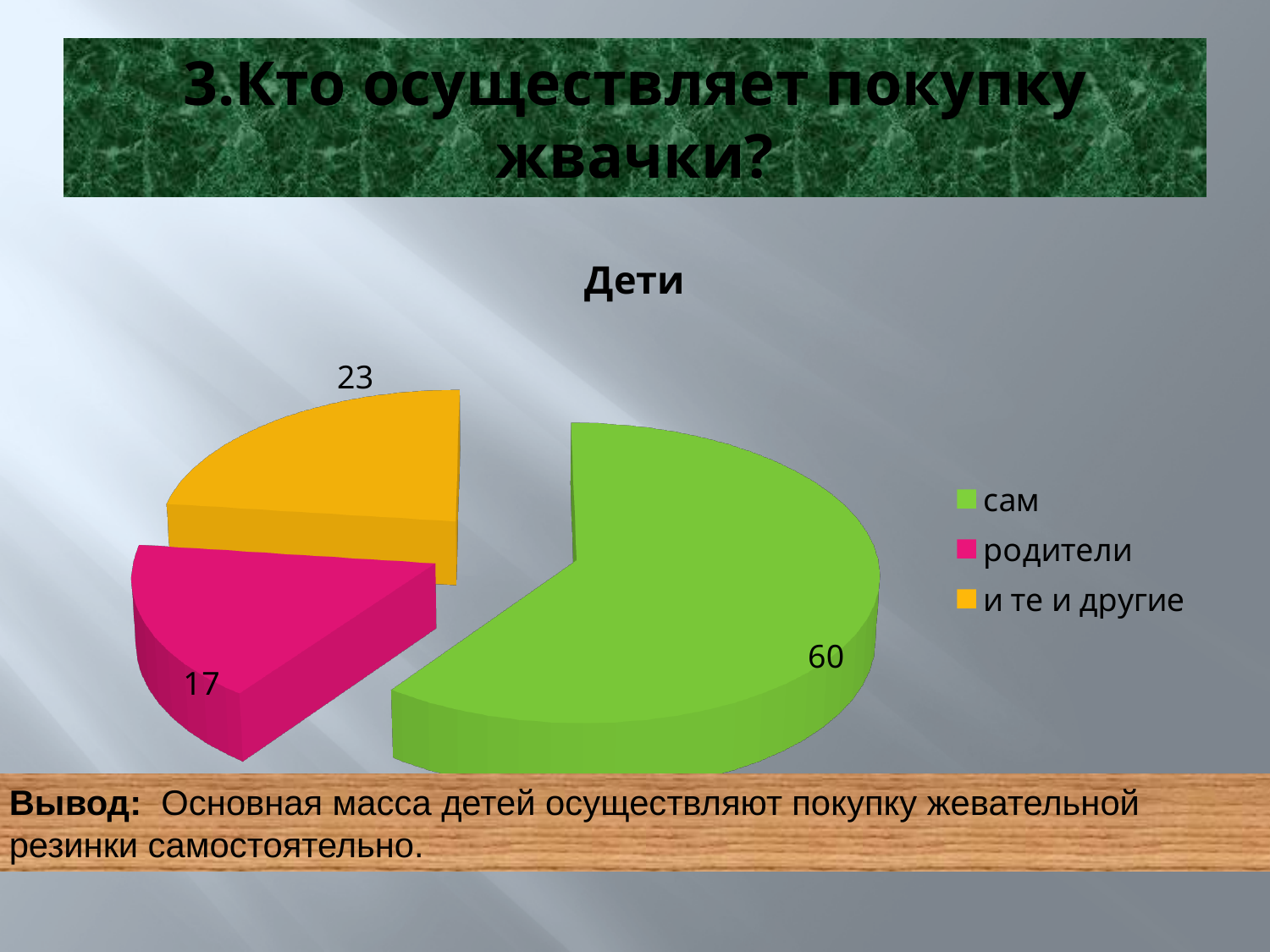
What is the difference between the values for 'и те и другие' and 'родители'? 6 What is the value for the 'родители' slice? 17 What is the difference between the values for 'сам' and 'родители'? 43 What is the value for the 'сам' slice? 60 How many slices does the pie chart have? 3 What is the title of the chart? Дети What share of the pie does the 'сам' slice represent? 60% Which is larger, the value for 'и те и другие' or the value for 'родители'? и те и другие Which category has the smallest slice? родители What type of chart is shown on the slide? pie chart Which category has the largest slice? сам What is the value for the 'и те и другие' slice? 23